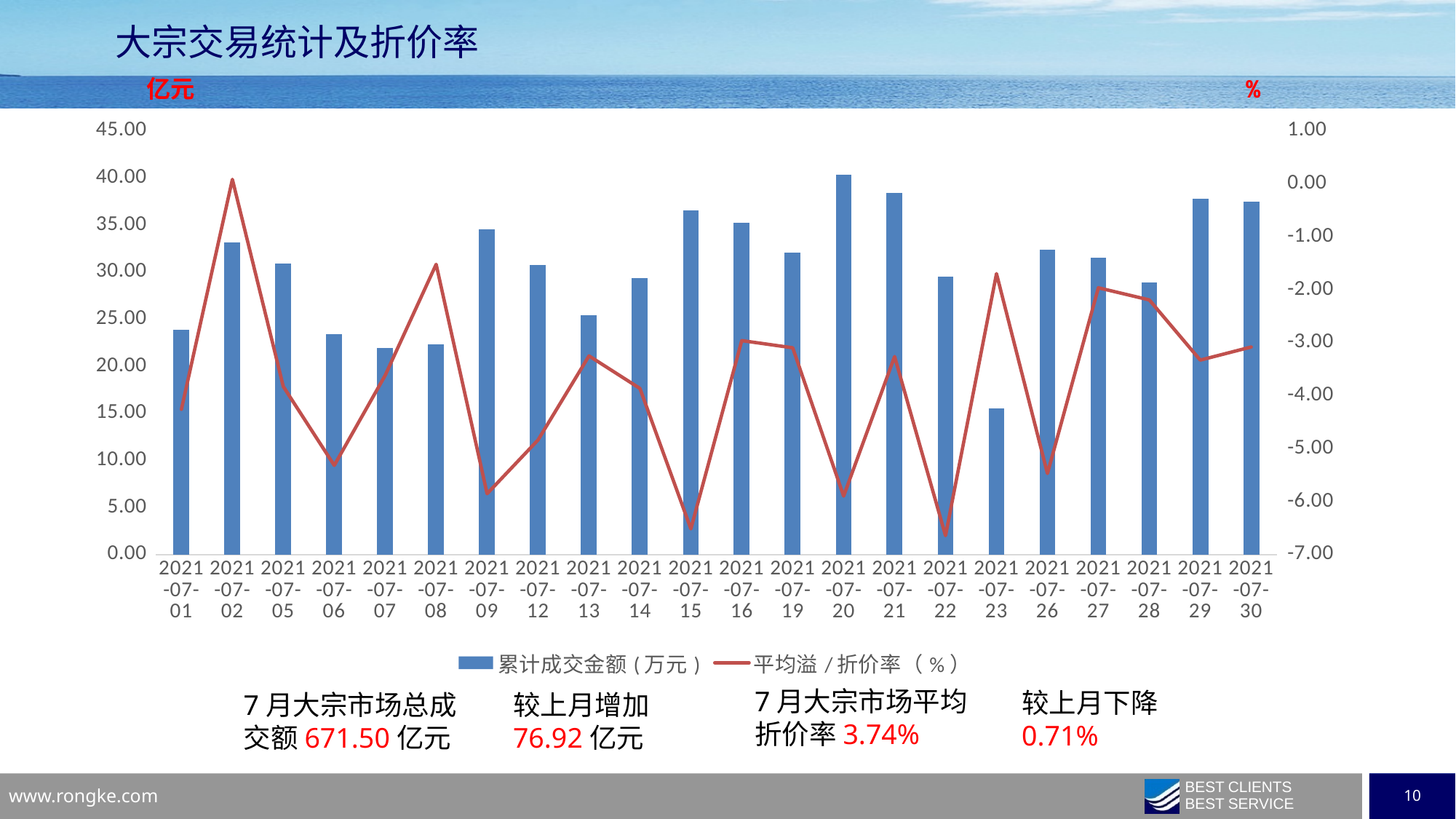
Is the 累计成交金额 value for 2021-07-23 greater or less than 20.00? less Is the 累计成交金额 value for 2021-07-02 greater or less than 30.00? greater How many series does the chart legend list? 2 On which date is the 累计成交金额 bar the lowest? 2021-07-23 Is the 累计成交金额 value for 2021-07-20 greater or less than 35.00? greater Do the 累计成交金额 bars rise or fall from 2021-07-05 to 2021-07-07? fall What kind of chart is shown on the slide? A combined bar and line chart How many dates are plotted along the x axis of the chart? 22 On which date is the 累计成交金额 bar the highest? 2021-07-20 On which date does the 平均溢/折价率 line reach its highest point? 2021-07-02 What unit label is shown above the left vertical axis of the chart? 亿元 Which has the larger 累计成交金额 bar, 2021-07-09 or 2021-07-13? 2021-07-09